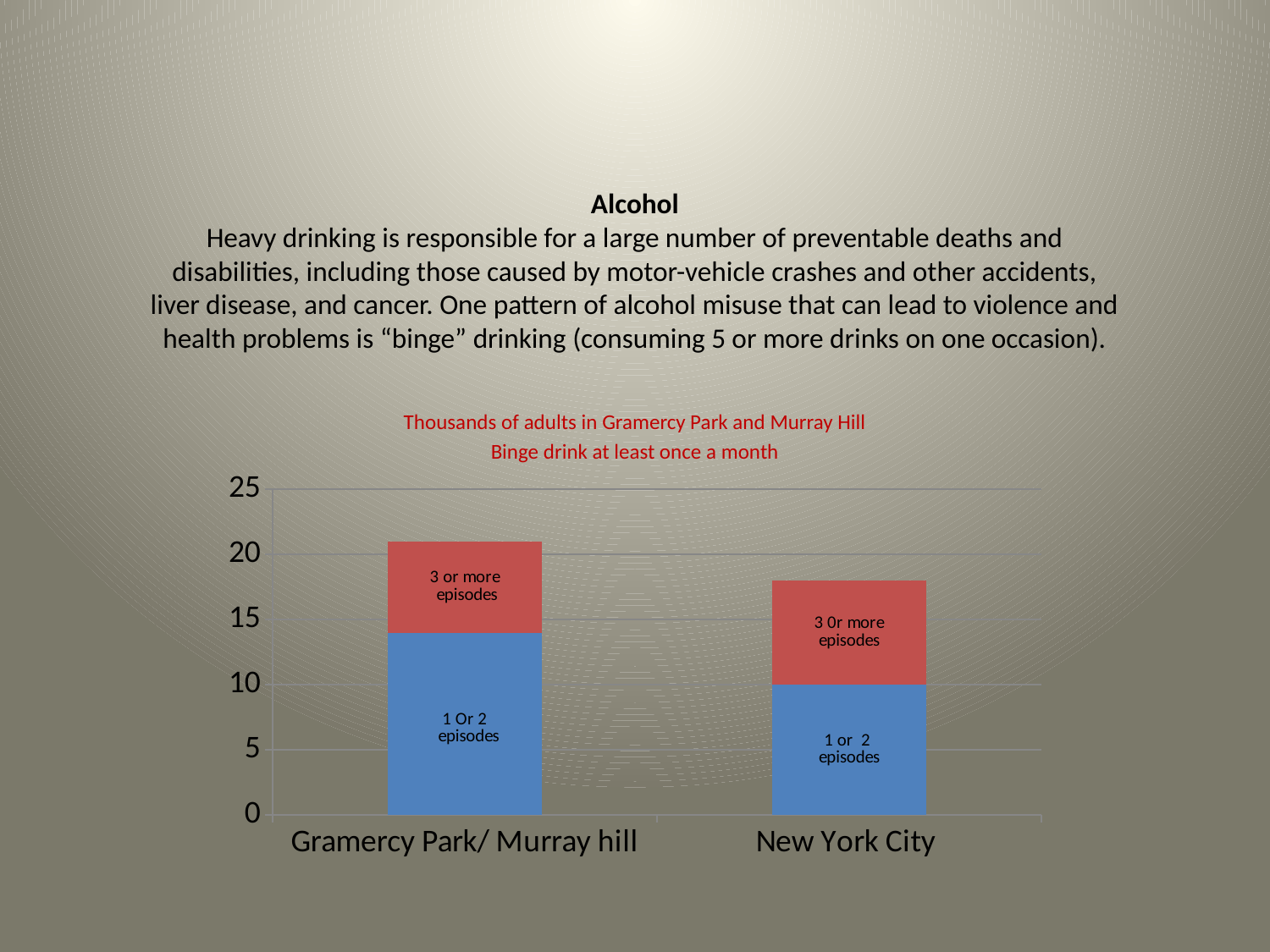
What colour is the '3 or more episodes' segment in the chart? Red Is the '1 Or 2 episodes' segment for Gramercy Park/ Murray hill greater or less than 10? greater Which category has the larger '1 or 2 episodes' segment, Gramercy Park/ Murray hill or New York City? Gramercy Park/ Murray hill Is the total bar for Gramercy Park/ Murray hill greater or less than 20? greater Which category has the shorter total bar? New York City Is the total bar for New York City greater or less than 20? less Which category has the taller total bar, Gramercy Park/ Murray hill or New York City? Gramercy Park/ Murray hill What kind of chart is shown on the slide? Stacked bar chart What is the title of the chart? Thousands of adults in Gramercy Park and Murray Hill Binge drink at least once a month For Gramercy Park/ Murray hill, which segment is larger, '1 Or 2 episodes' or '3 or more episodes'? 1 Or 2 episodes How many categories are shown on the x axis of the chart? 2